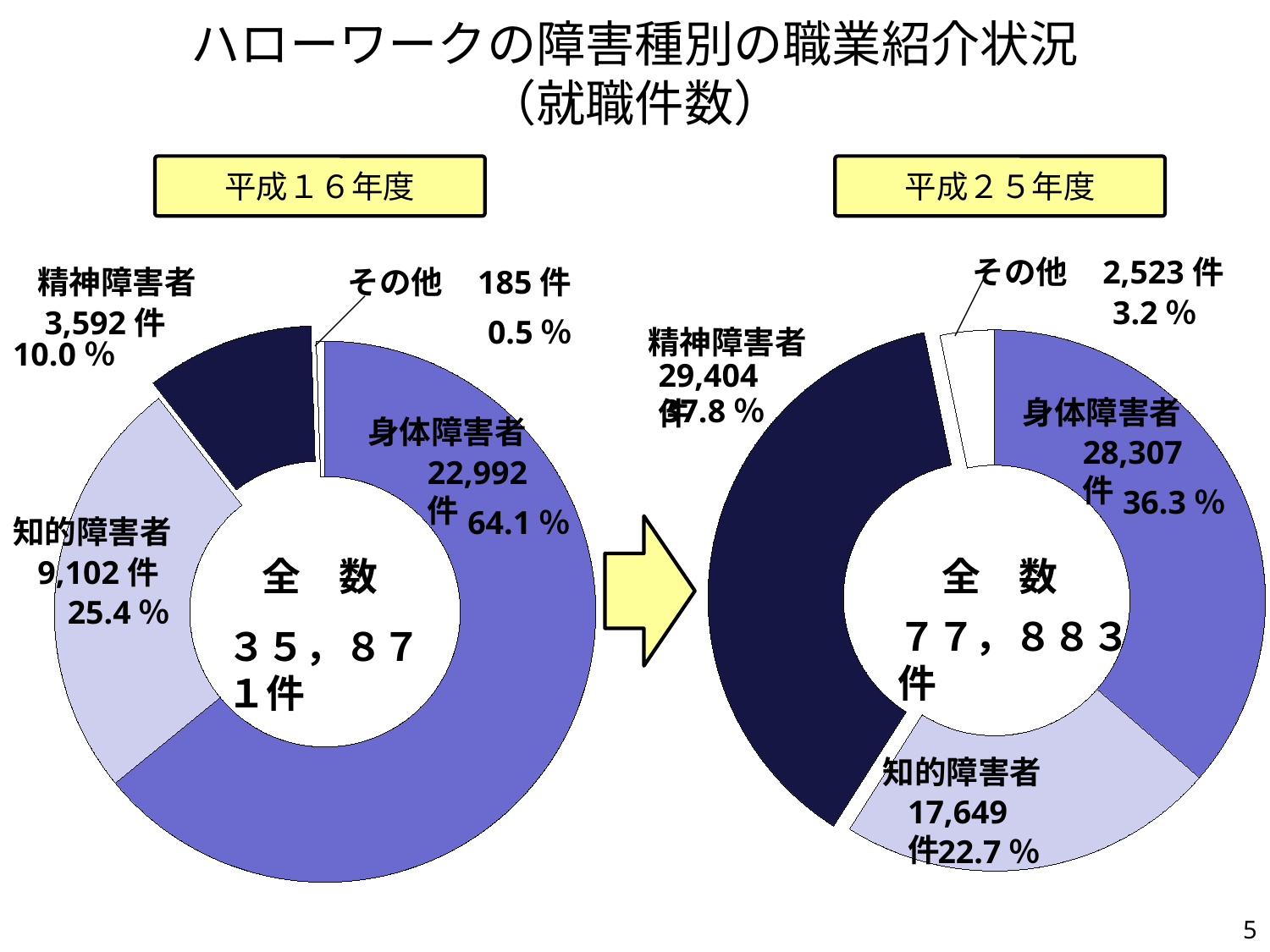
In the 平成16年度 chart, what is the total number (全数) shown in the centre? 35,871件 In the 平成16年度 chart, which category has the smallest share? その他 What kind of chart is used on this slide? Donut (pie) chart In the 平成16年度 chart, how many cases are shown for 身体障害者? 22,992件 In the 平成25年度 chart, what is the total number (全数) shown in the centre? 77,883件 How many categories does each donut chart on the slide show? 4 In the 平成25年度 chart, what share of the total is その他? 3.2% In the 平成16年度 chart, what share of the total is 知的障害者? 25.4% In the 平成16年度 chart, what is the difference in cases between 知的障害者 and 精神障害者? 5,510件 In the 平成25年度 chart, which has more cases, 身体障害者 or 知的障害者? 身体障害者 In the 平成25年度 chart, how many cases are shown for 精神障害者? 29,404件 In the 平成25年度 chart, what is the difference in cases between 身体障害者 and 知的障害者? 10,658件